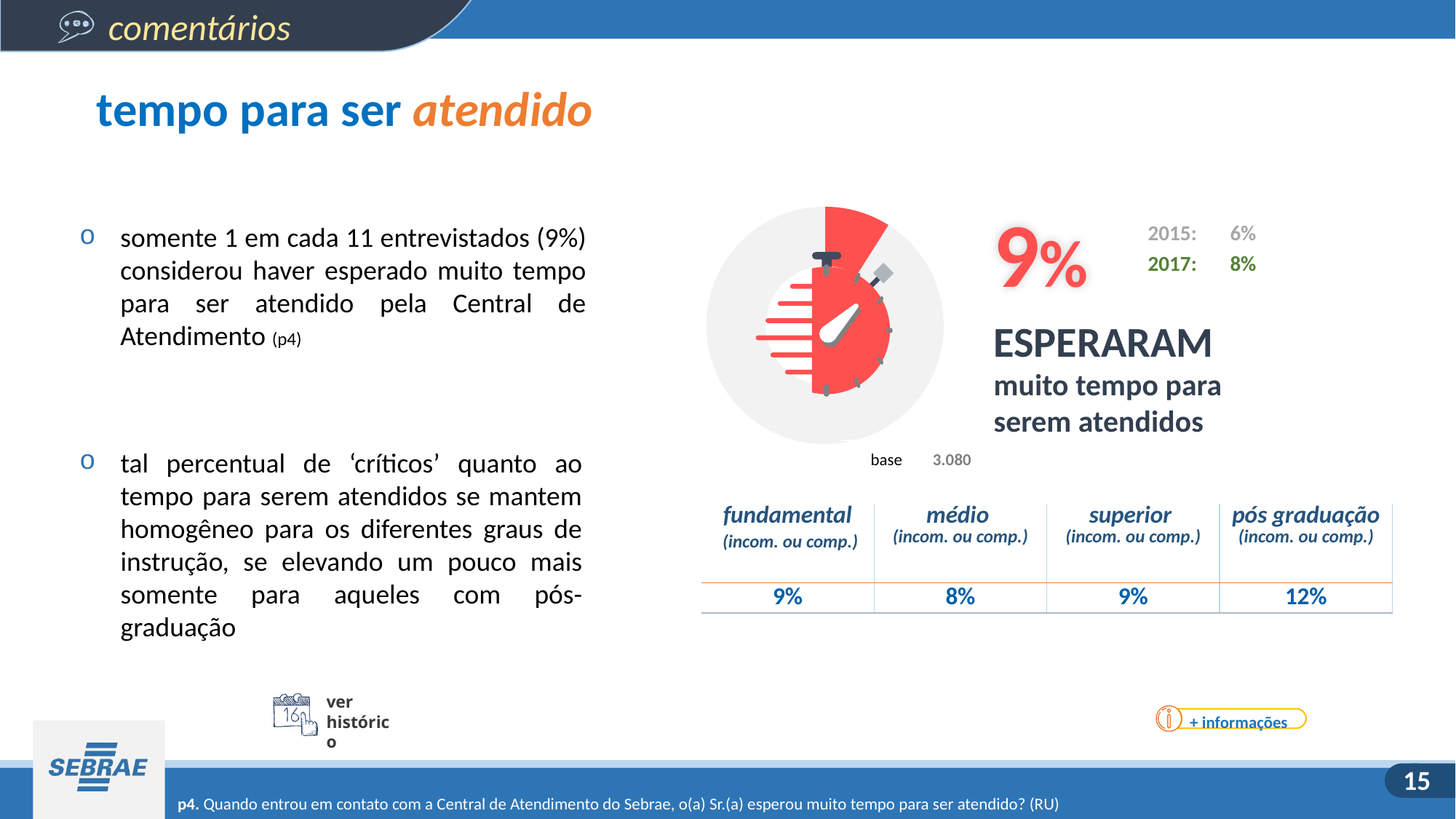
In the table below the pie chart, which education level has the lowest value? médio What is the difference between the current value (9%) and the 2015 value shown next to the pie chart? 3 percentage points What is the base (number of respondents) shown under the pie chart? 3.080 Next to the pie chart, what was the value for 2017? 8% What kind of chart is the graphic with the stopwatch on the right of the slide? pie chart In the table below the pie chart, which education level has the highest value? pós graduação In the pie chart with the stopwatch, what percentage of respondents waited a long time to be served? 9% How many education levels are listed in the table below the pie chart? 4 In the table below the pie chart, what is the value for 'médio'? 8% Next to the pie chart, what was the value for 2015? 6% In the table below the pie chart, what is the value for 'pós graduação'? 12% Did the percentage of respondents who waited a long time rise or fall from 2015 to the current 9%? rise